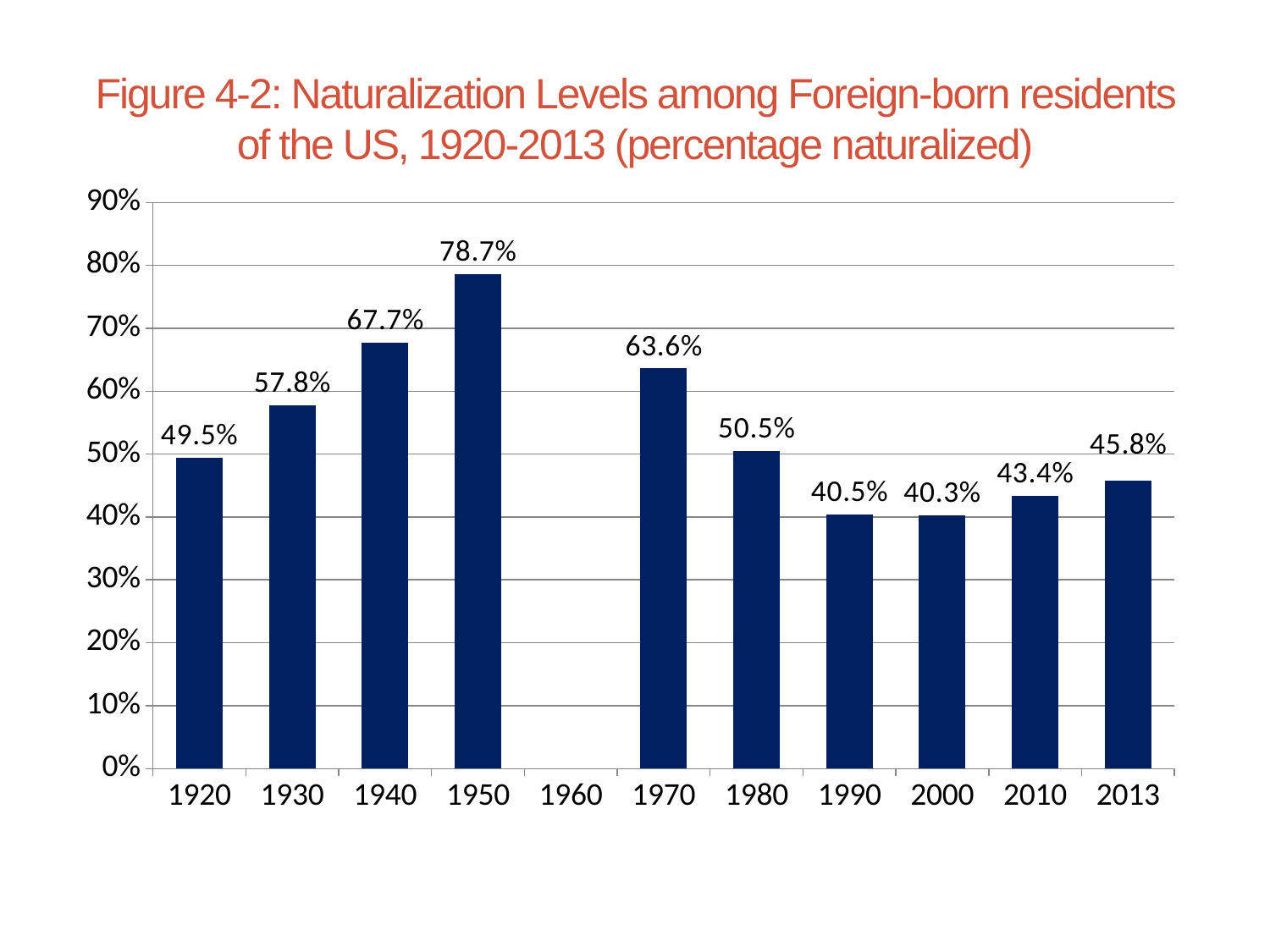
What kind of chart is shown on the slide? bar chart What is the value shown for 2013? 45.8% How many bars are plotted on the chart? 10 Which year on the x axis has no bar plotted? 1960 What is the difference in percentage points between the 1950 value and the 1920 value? 29.2 Is the value for 1980 greater or less than 60%? less What is the value shown for 1920? 49.5% Which year has the highest percentage naturalized? 1950 What is the difference in percentage points between the 1970 value and the 1980 value? 13.1 What percentage of foreign-born residents were naturalized in 1950? 78.7% Do the values rise or fall from 1920 to 1950? rise Which is larger, the value for 1940 or the value for 1970? 1940